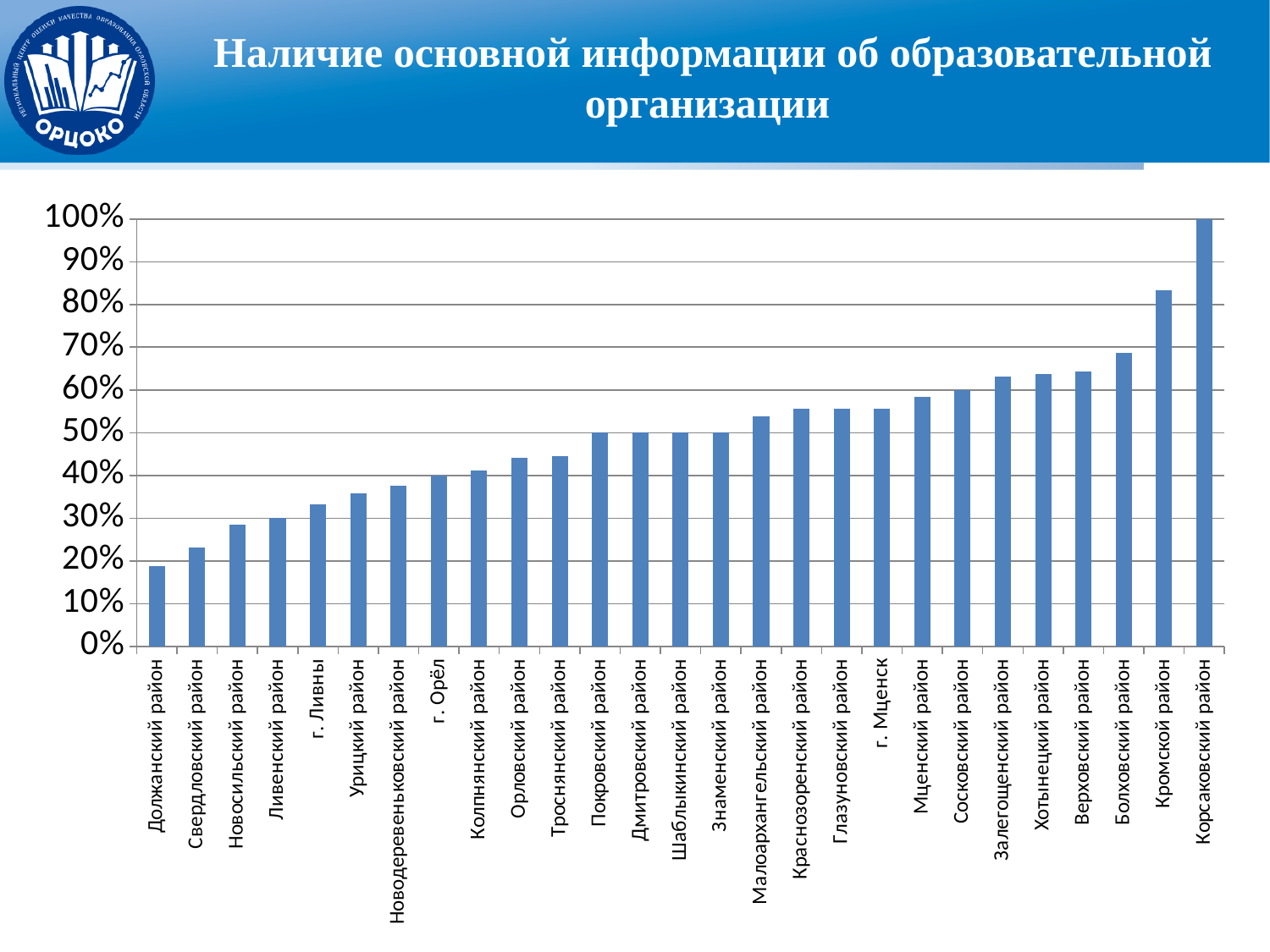
Is the value for Кромской район greater or less than 80%? greater Is the value for Болховский район greater or less than 70%? less How many districts (categories) are shown on the chart? 27 Do the values rise or fall from left to right along the x axis? rise Which is larger, the value for Кромской район or for Болховский район? Кромской район What is the value for Корсаковский район? 100% Which district has the highest value on the chart? Корсаковский район Is the value for Малоархангельский район greater or less than 50%? greater What kind of chart is shown on the slide? bar chart Which district has the lowest value on the chart? Должанский район What is the title of the slide containing the chart? Наличие основной информации об образовательной организации